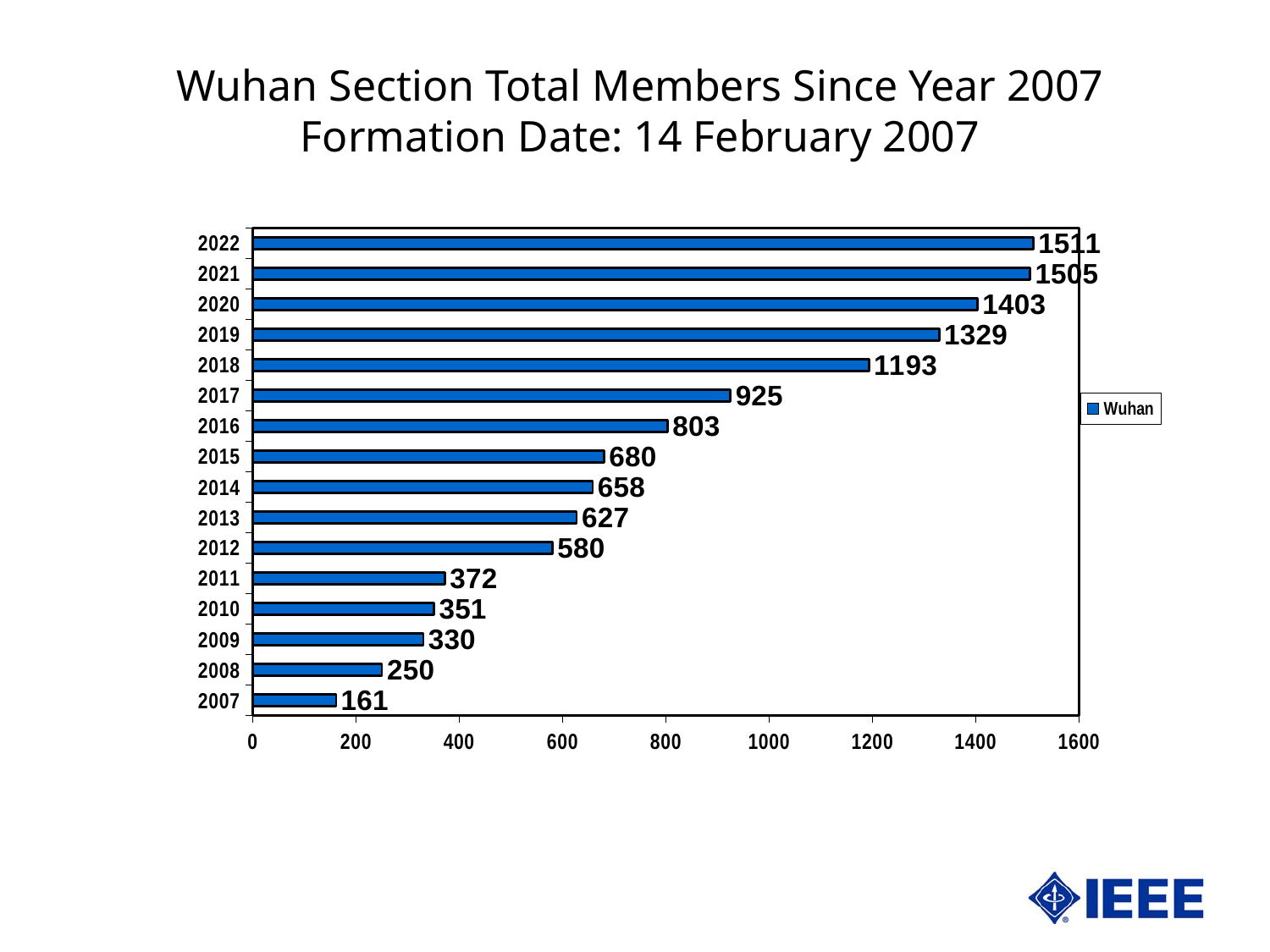
Which year has the lowest number of members? 2007 How many series does the legend list? 1 Which year has the highest number of members? 2022 What is the total number of Wuhan Section members in 2007? 161 Which year has more members, 2013 or 2016? 2016 Do the member counts rise or fall from 2007 to 2022? Rise What is the difference in members between 2022 and 2021? 6 What is the difference in members between 2018 and 2017? 268 What is the total number of Wuhan Section members in 2022? 1511 How many years are shown on the chart? 16 What kind of chart is shown on the slide? Bar chart What is the total number of Wuhan Section members in 2015? 680